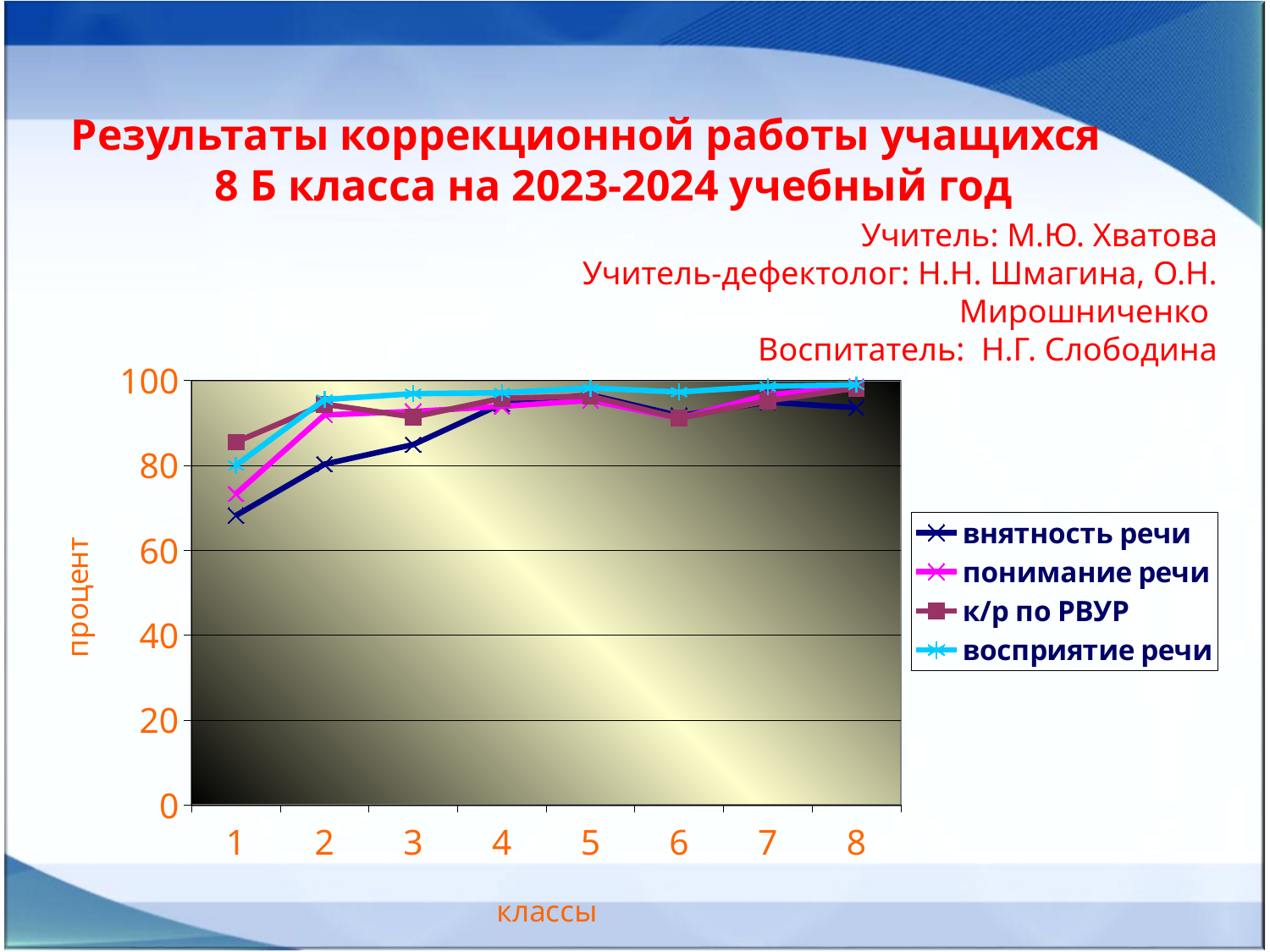
What is the title of the vertical axis? процент How many series does the legend list? 4 Is the value for восприятие речи at class 2 greater or less than 80? greater Is the value for внятность речи at class 1 greater or less than 80? less At class 1, which is larger: the value for внятность речи or the value for восприятие речи? восприятие речи How many categories are shown along the x axis? 8 What kind of chart is shown on the slide? line chart Do the values for внятность речи generally rise or fall from class 1 to class 8? rise Is the value for понимание речи at class 1 greater or less than 80? less Which series has the lowest value at class 1? внятность речи Which series has the highest value at class 1? к/р по РВУР